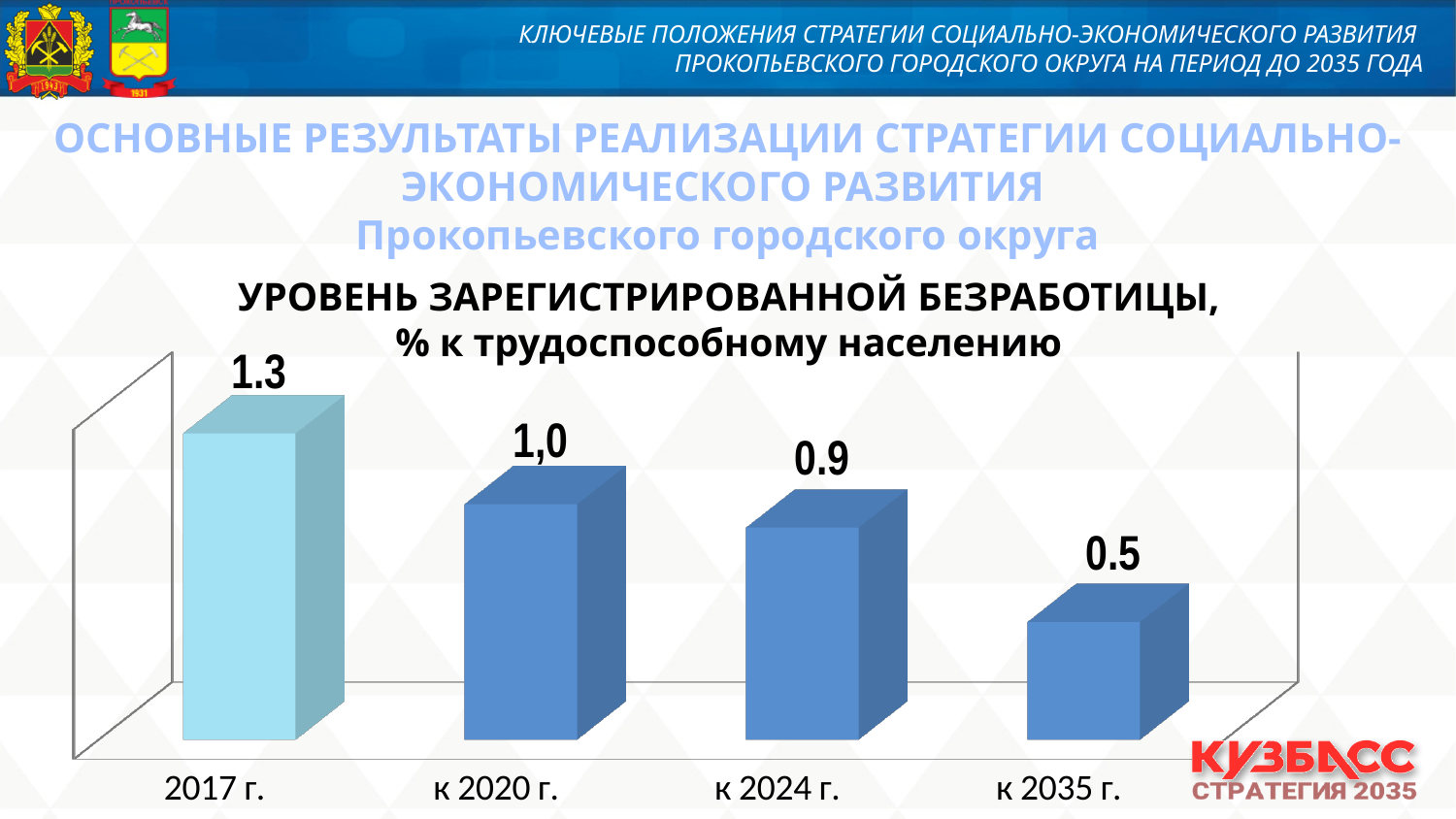
Which category has the lowest value? к 2035 г. How many categories are shown on the x axis? 4 Which is larger, the value for к 2020 г. or the value for к 2035 г.? к 2020 г. What value is shown for к 2035 г.? 0.5 Which category has the highest value? 2017 г. Do the values rise or fall from 2017 г. to к 2035 г.? Fall What is the difference between the values for 2017 г. and к 2035 г.? 0.8 What value is shown for к 2020 г.? 1,0 What is the registered unemployment rate shown for 2017 г.? 1.3 What is the difference between the values for к 2024 г. and к 2035 г.? 0.4 What kind of chart is shown on the slide? Bar chart What value is shown for к 2024 г.? 0.9